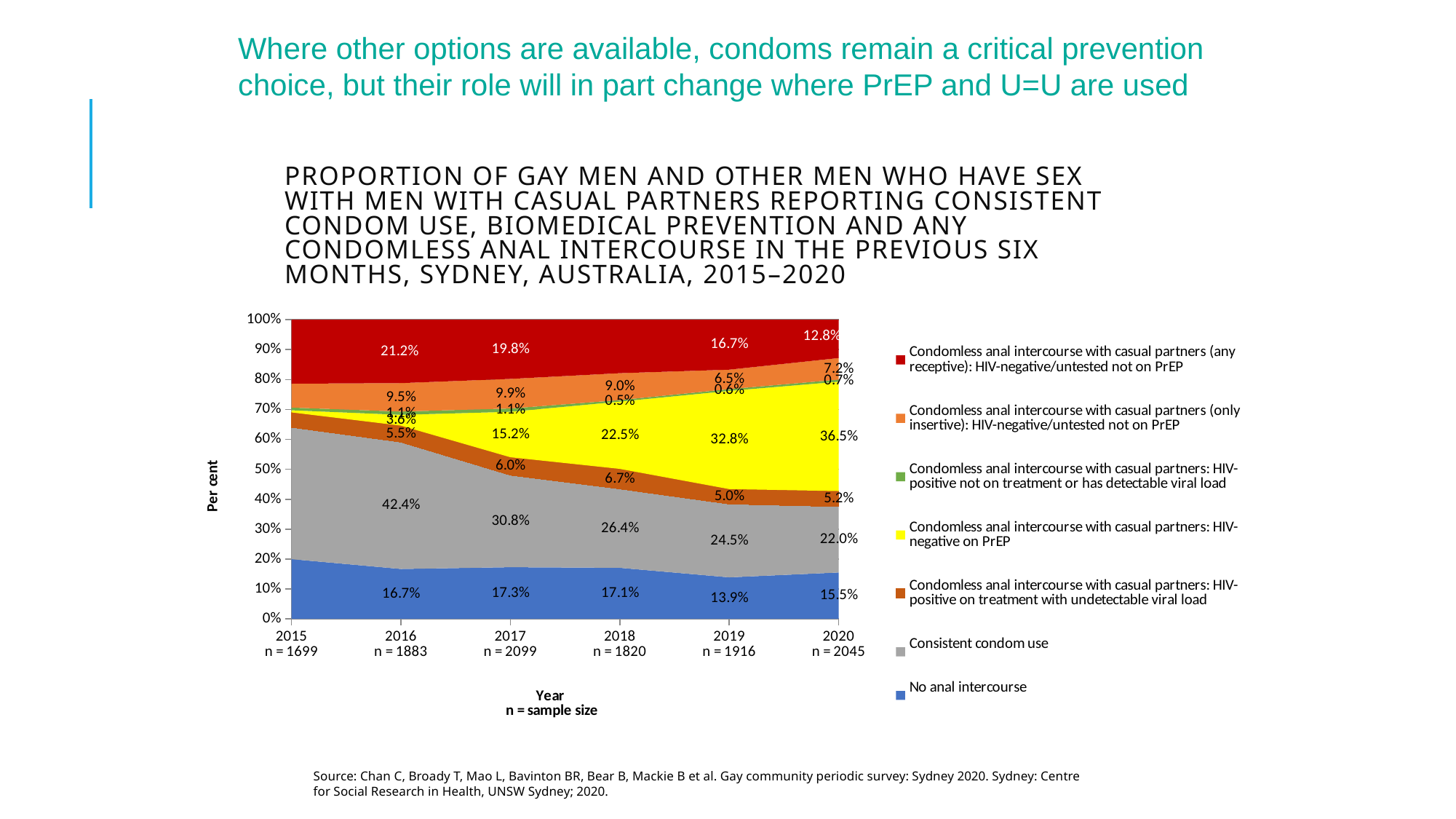
What colour represents 'Consistent condom use' in the chart? Grey What is the difference between the 'HIV-negative on PrEP' values in 2020 and 2019? 3.7 percentage points What is the sample size (n) for 2017? 2099 In which year is the 'HIV-negative on PrEP' series highest? 2020 Does the 'Consistent condom use' series rise or fall from 2016 to 2020? Fall What is the value for 'No anal intercourse' in 2019? 13.9% How many series does the legend list? 7 What type of chart is shown on the slide? Stacked area chart How many years are shown along the x axis? 6 What is the value for 'Condomless anal intercourse with casual partners: HIV-negative on PrEP' in 2020? 36.5% In 2020, which is larger: 'Consistent condom use' or 'No anal intercourse'? Consistent condom use What is the value for 'Consistent condom use' in 2020? 22.0%